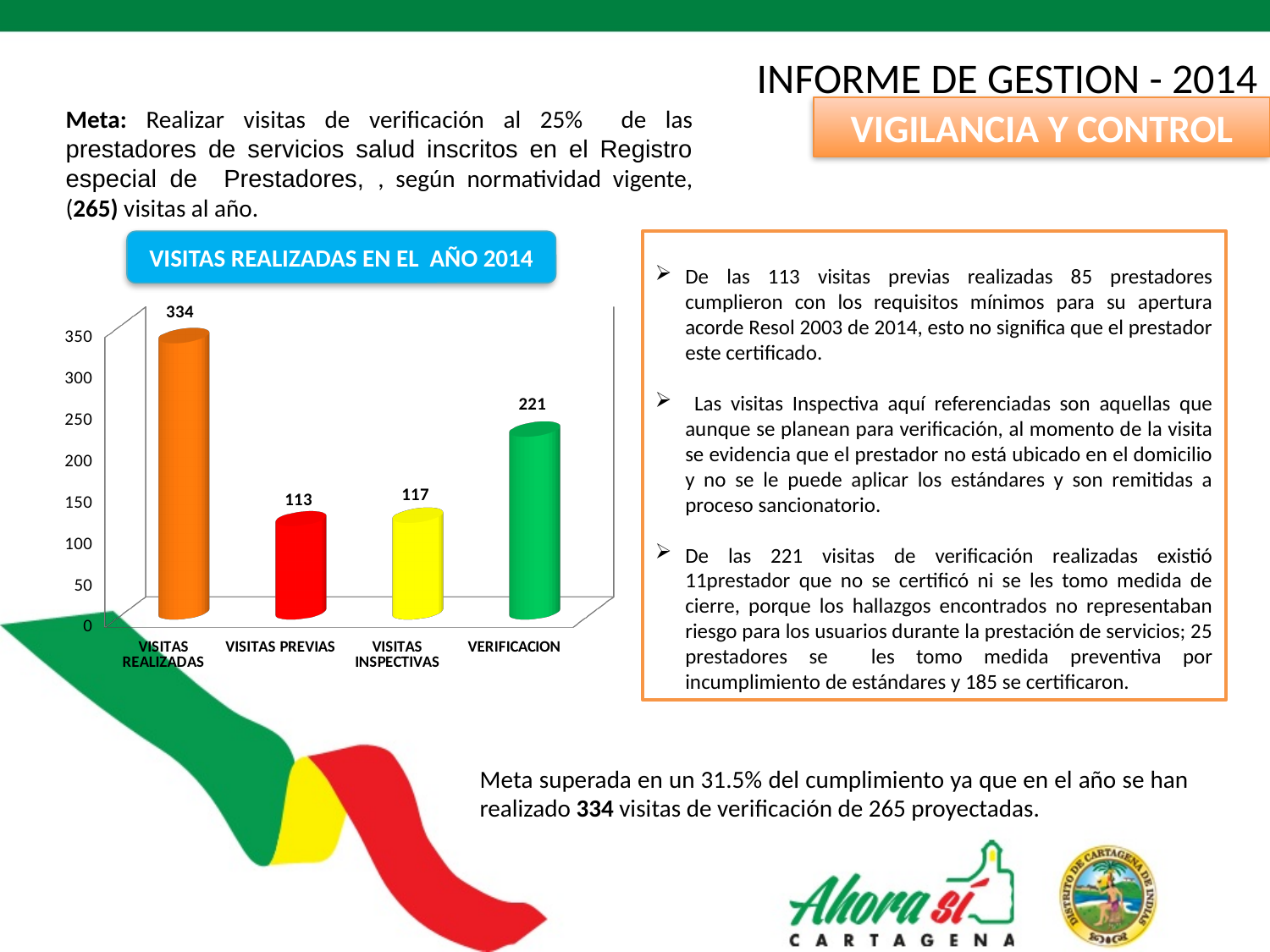
Which category has the lowest value? VISITAS PREVIAS How many categories are shown in the chart? 4 Which category has the highest value? VISITAS REALIZADAS Which is larger, VERIFICACION or VISITAS INSPECTIVAS? VERIFICACION What is the value for VISITAS REALIZADAS? 334 What is the difference between VISITAS REALIZADAS and VERIFICACION? 113 What kind of chart is shown on the slide? Bar chart What is the value for VERIFICACION? 221 What is the title of the chart? VISITAS REALIZADAS EN EL AÑO 2014 What is the difference between VISITAS INSPECTIVAS and VISITAS PREVIAS? 4 What is the value for VISITAS INSPECTIVAS? 117 What is the value for VISITAS PREVIAS? 113